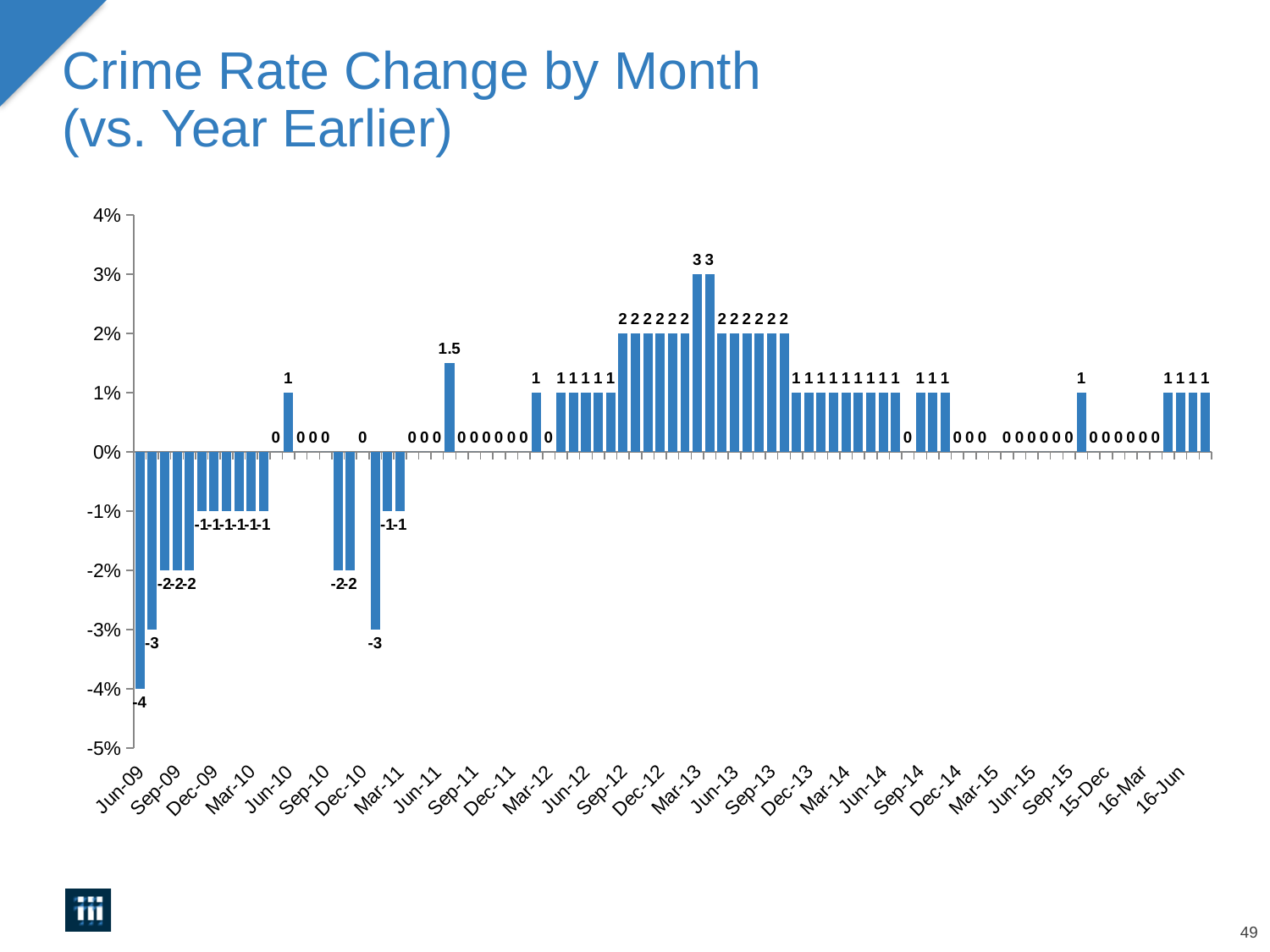
How many bars in the chart have a data label of 3? 2 What is the highest value shown on the vertical axis? 4% Which is larger: the value for Jun-09 or the value of the bar labelled 1.5? the bar labelled 1.5 What type of chart is shown on the slide? bar chart What is the title of the chart? Crime Rate Change by Month (vs. Year Earlier) Do the values generally rise or fall from Jun-09 to Mar-13? rise Is the value for Jun-09 greater or less than -3%? less What is the difference between the highest value (3) and the lowest value (-4) in the chart? 7 What is the crime rate change value for Jun-09, the first bar in the chart? -4 What is the value of the bar immediately after the -4 bar at Jun-09? -3 What is the highest value shown in the chart? 3 What is the lowest value shown in the chart? -4